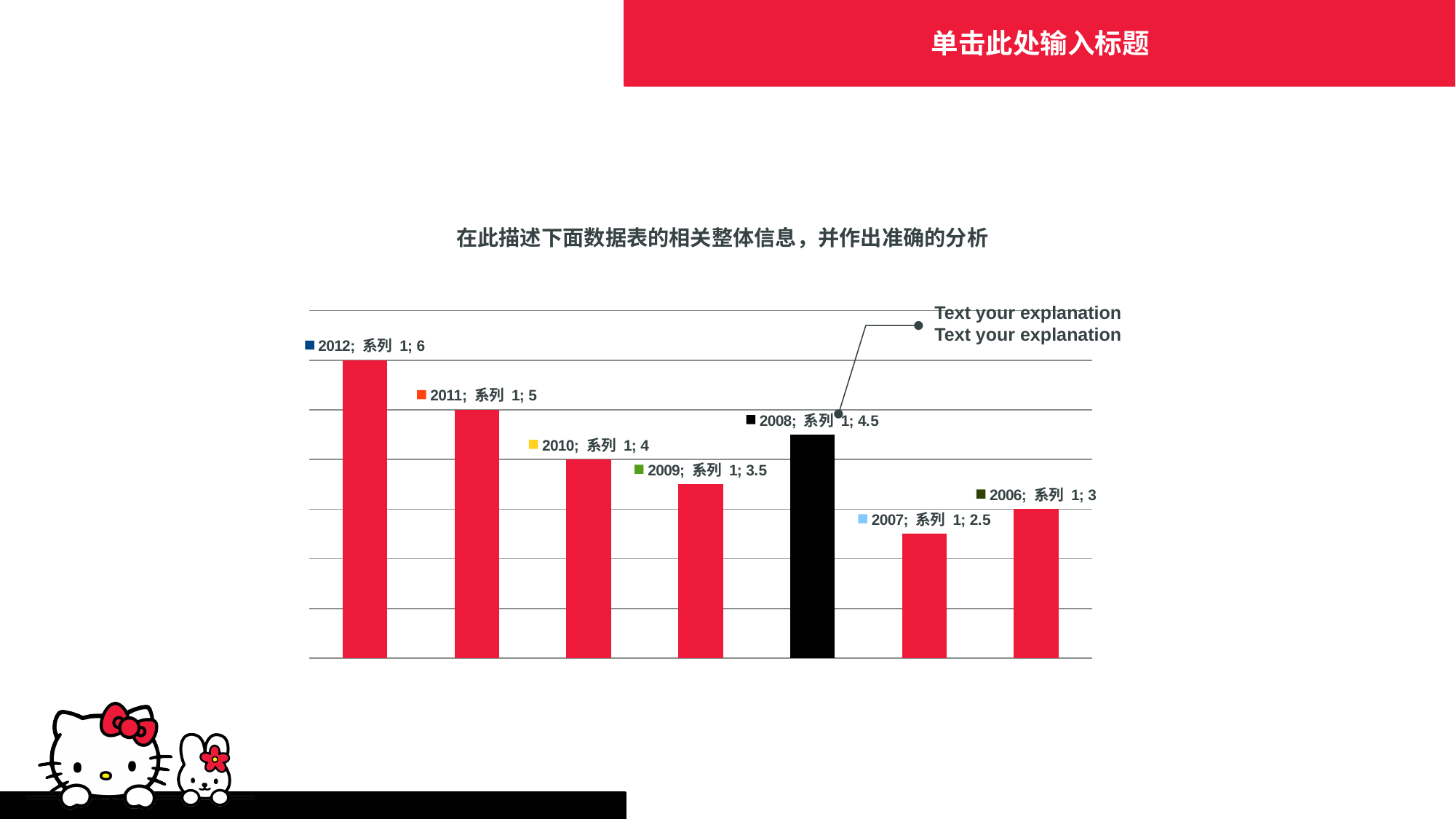
What is the difference between the values for 2012 and 2011? 1 What is the value for 2012? 6 What is the value for 2009? 3.5 What is the value for 2007? 2.5 Which year has the lowest value? 2007 What kind of chart is shown on the slide? Bar chart How many bars are shown in the chart? 7 Which is larger, the value for 2010 or the value for 2006? 2010 What is the difference between the values for 2008 and 2007? 2 Which year has the highest value? 2012 What is the value for 2008? 4.5 Which year's bar is coloured black instead of red? 2008